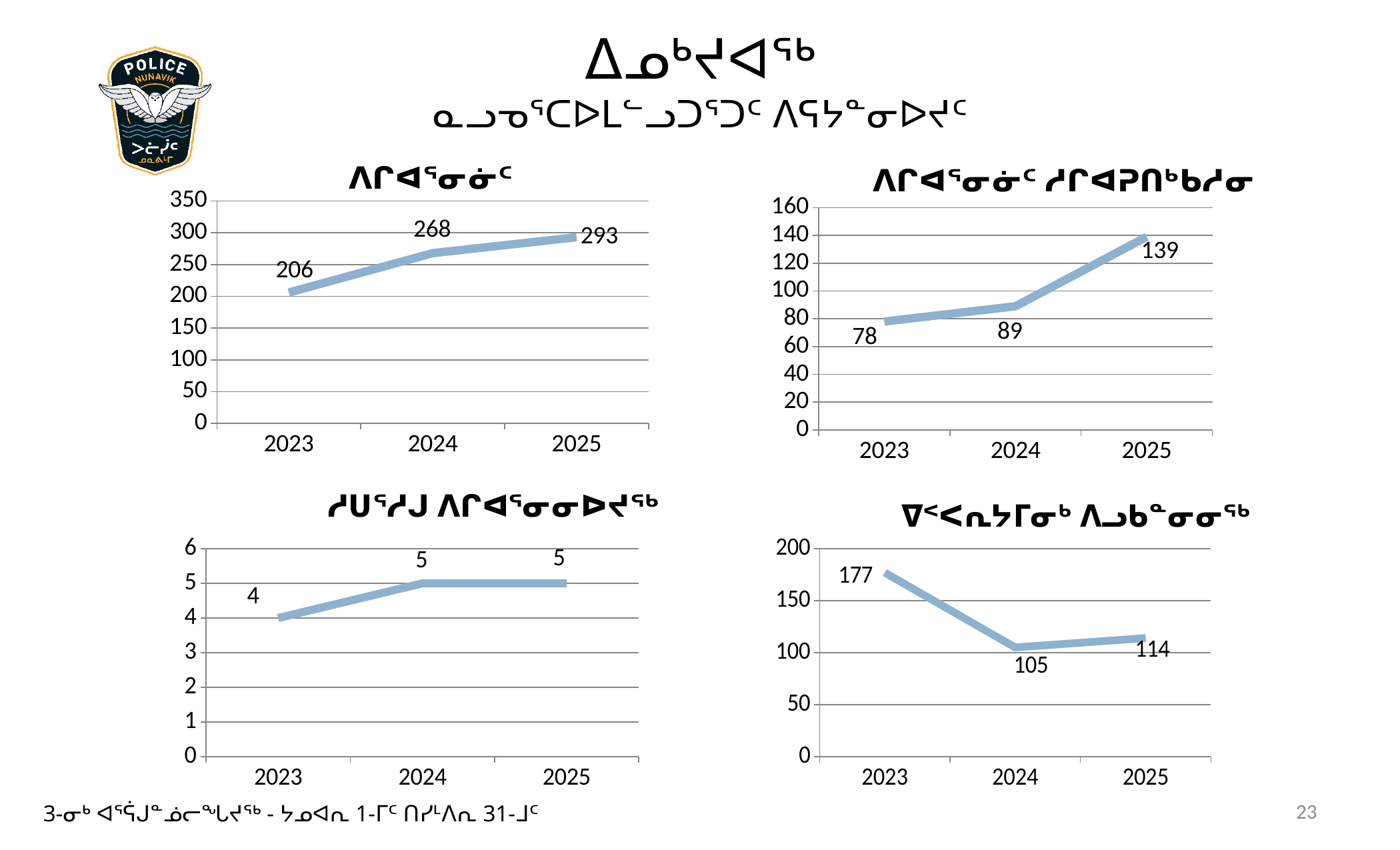
What kind of chart is the top-right chart? line chart In the top-left chart, which year has the highest value? 2025 In the bottom-right chart, what is the difference between the 2023 and 2024 values? 72 In the top-right chart, what is the value for 2025? 139 In the bottom-right chart, which is larger, the value for 2023 or the value for 2025? 2023 In the bottom-left chart, what is the value for 2023? 4 In the bottom-right chart, what is the value for 2024? 105 In the top-right chart, which year has the lowest value? 2023 In the top-left chart, what is the value for 2024? 268 In the bottom-left chart, how many years are plotted on the x axis? 3 In the top-left chart, what is the difference between the 2025 and 2023 values? 87 In the top-right chart, do the values rise or fall from 2023 to 2025? rise